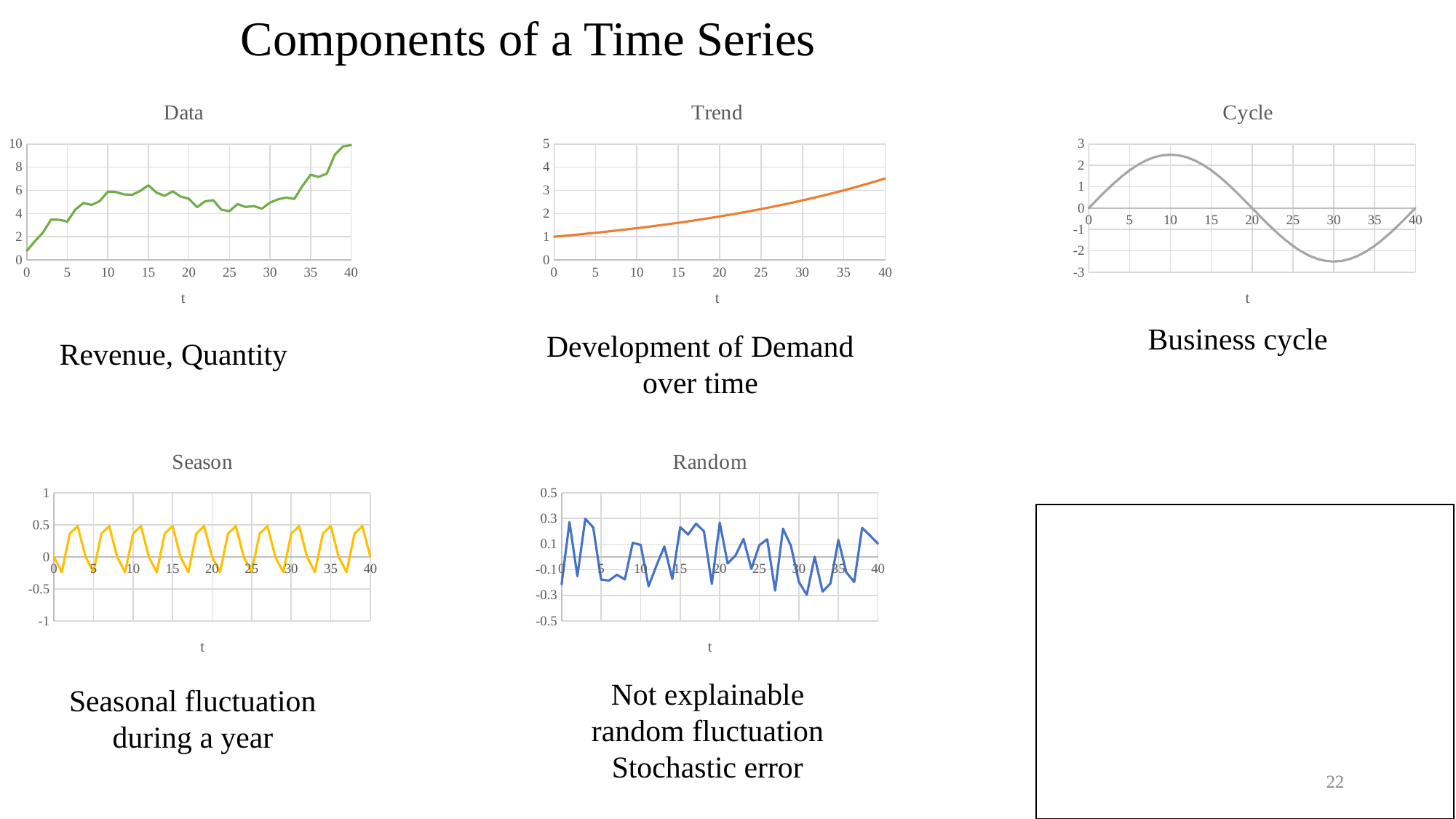
What colour is the line in the 'Random' chart? blue In the 'Cycle' chart, is the value at t=30 greater or less than -2? less In the 'Data' chart, is the value at t=0 greater or less than 2? less In the 'Season' chart, are the peak values greater or less than 1? less What kind of chart is the 'Data' chart? line chart How many charts are shown on the slide? 5 What is the x-axis label on the 'Season' chart? t In the 'Trend' chart, do the values rise or fall as t increases along the x axis? rise